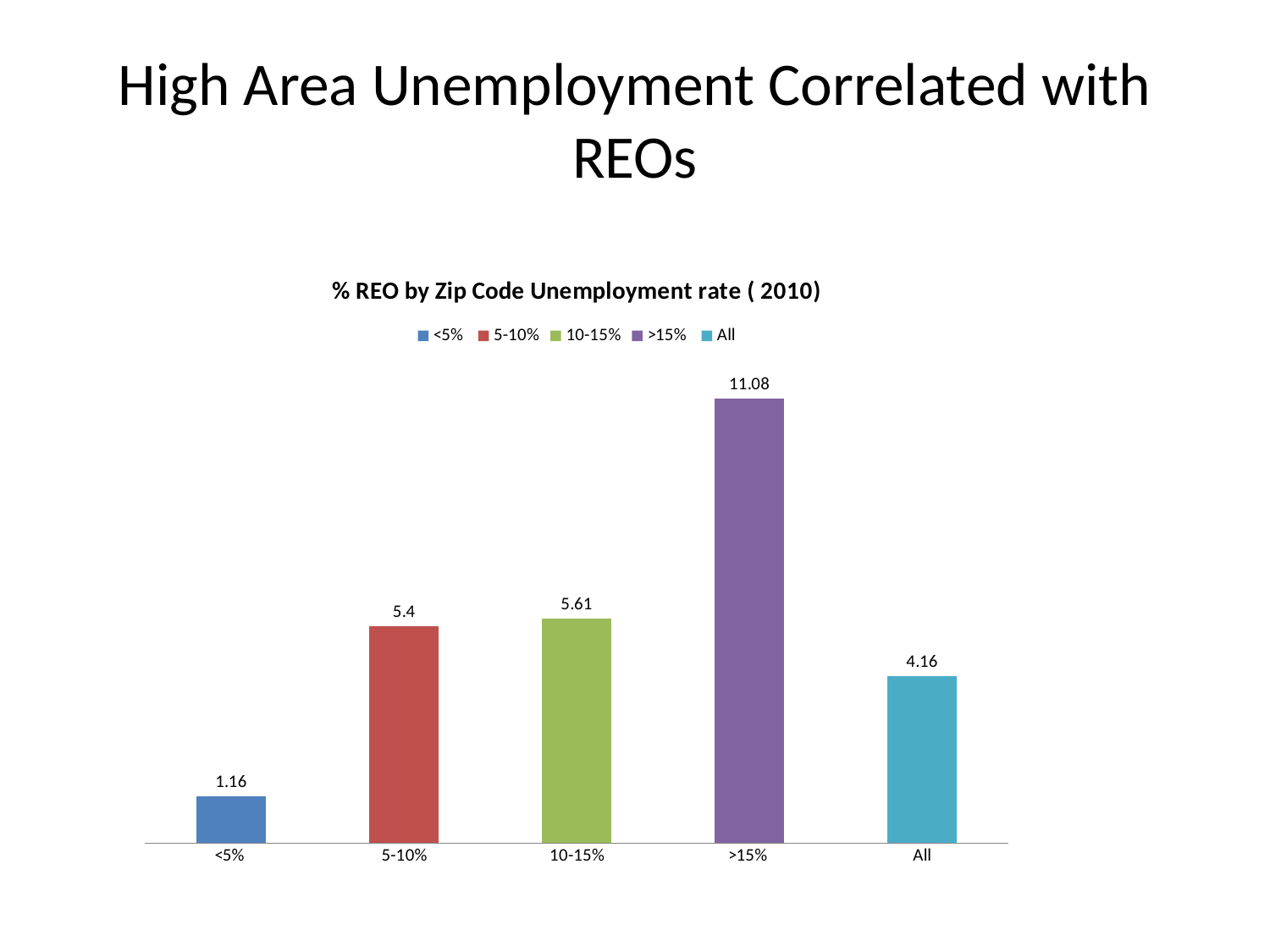
What is the difference between the values for >15% and <5%? 9.92 Which is larger, the value for >15% or the value for All? >15% Which category has the lowest value? <5% What is the title of the chart? % REO by Zip Code Unemployment rate ( 2010) What is the value for the <5% category? 1.16 How many categories are shown on the x axis? 5 What is the value for the All category? 4.16 What is the difference between the values for 10-15% and 5-10%? 0.21 What is the value for the 5-10% category? 5.4 What is the value for the >15% category? 11.08 What kind of chart is shown on the slide? Bar chart Which category has the highest value? >15%